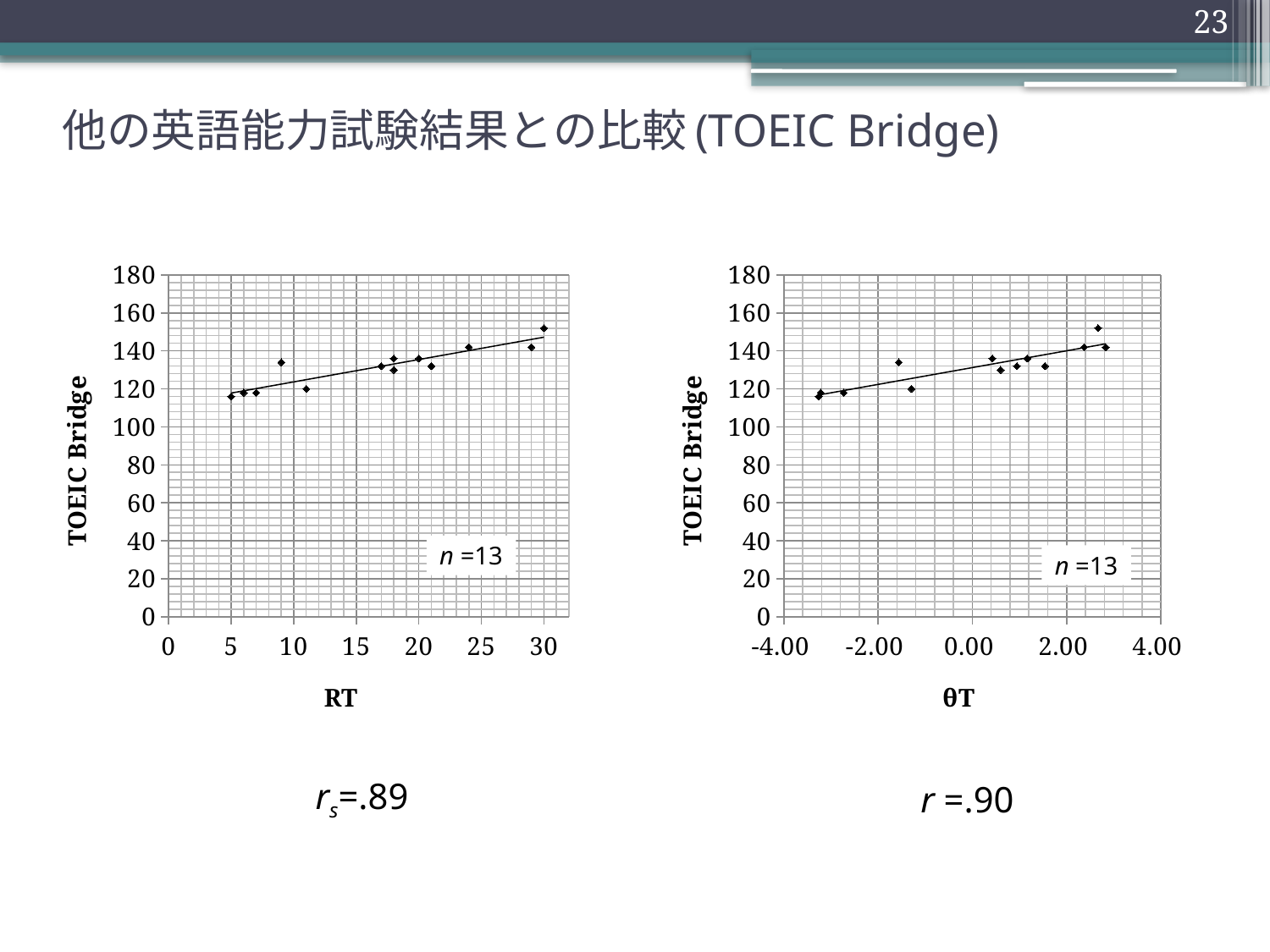
In the left chart, do TOEIC Bridge values generally rise or fall as RT increases? rise In the right chart, how many data points are plotted according to the n shown on the chart? 13 In the left chart, is the TOEIC Bridge value for the point at RT = 30 greater or less than 140? greater In the right chart, is the TOEIC Bridge value for the highest point (near θT = 3.00) greater or less than 140? greater In the left chart, is the TOEIC Bridge value for the point at RT = 5 greater or less than 120? less What kind of chart is the right chart (θT vs TOEIC Bridge)? scatter chart In the left chart, how many data points are plotted according to the n shown on the chart? 13 What is the x-axis label of the left chart? RT What kind of chart is the left chart (RT vs TOEIC Bridge)? scatter chart In the right chart, do TOEIC Bridge values generally rise or fall as θT increases? rise What is the y-axis label of the right chart? TOEIC Bridge